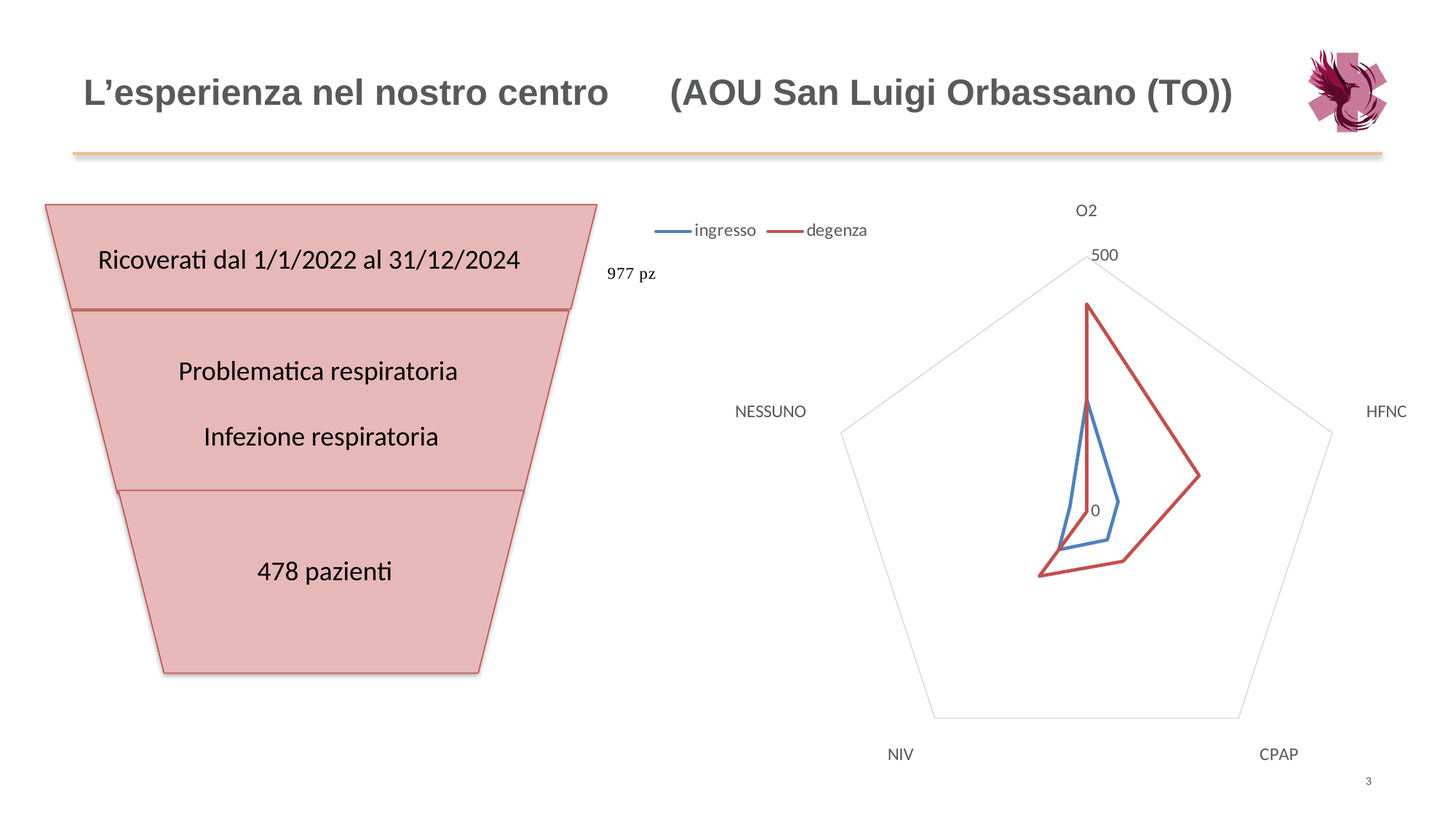
In the radar chart, which series has the larger value for O2, ingresso or degenza? degenza How many categories (axes) does the radar chart have? 5 In the radar chart, which series has the larger value for HFNC, ingresso or degenza? degenza What is the maximum value shown on the radial axis of the radar chart? 500 Which category has the highest value for the degenza series in the radar chart? O2 Is the degenza value for O2 in the radar chart greater or less than 250? greater What kind of chart is shown on the right of the slide? radar chart Is the ingresso value for HFNC in the radar chart greater or less than 250? less How many series does the legend of the radar chart list? 2 What are the two series named in the legend of the radar chart? ingresso and degenza Which category has the lowest value for the degenza series in the radar chart? NESSUNO Is the degenza value for HFNC in the radar chart greater or less than 500? less